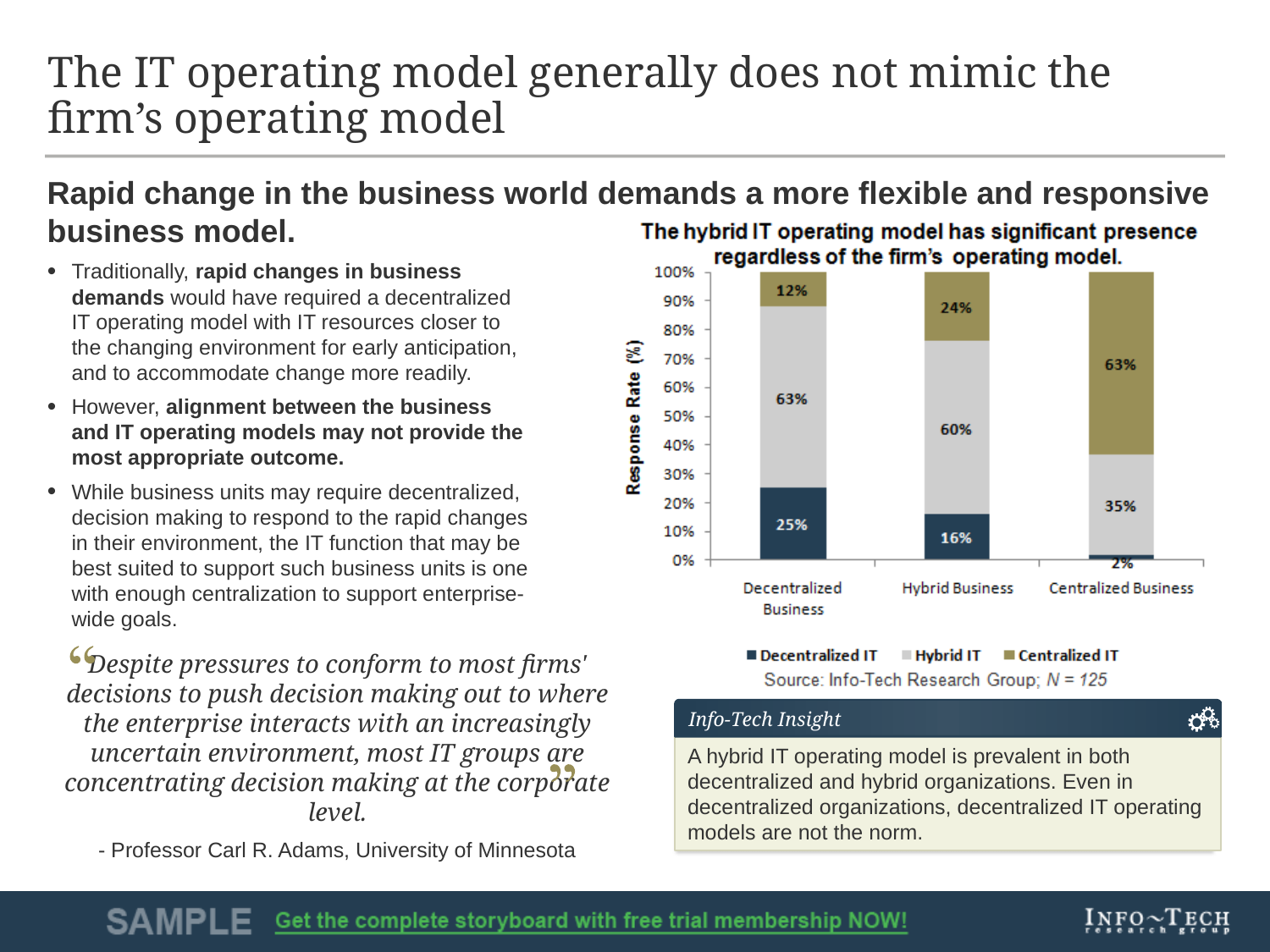
Which business category has the highest Decentralized IT value? Decentralized Business How many series does the legend list? 3 What is the difference between the Hybrid IT values for Decentralized Business and Hybrid Business? 3% What is the total of the stacked bar for Hybrid Business? 100% How many business categories are shown on the x axis? 3 What is the Decentralized IT value for Centralized Business? 2% Which business category has the lowest Centralized IT value? Decentralized Business What is the Hybrid IT value for Decentralized Business? 63% Which is larger: the Decentralized IT value for Decentralized Business or the Decentralized IT value for Hybrid Business? Decentralized Business What kind of chart is shown on the slide? Stacked bar chart What is the Hybrid IT value for Centralized Business? 35% What is the Centralized IT value for Hybrid Business? 24%